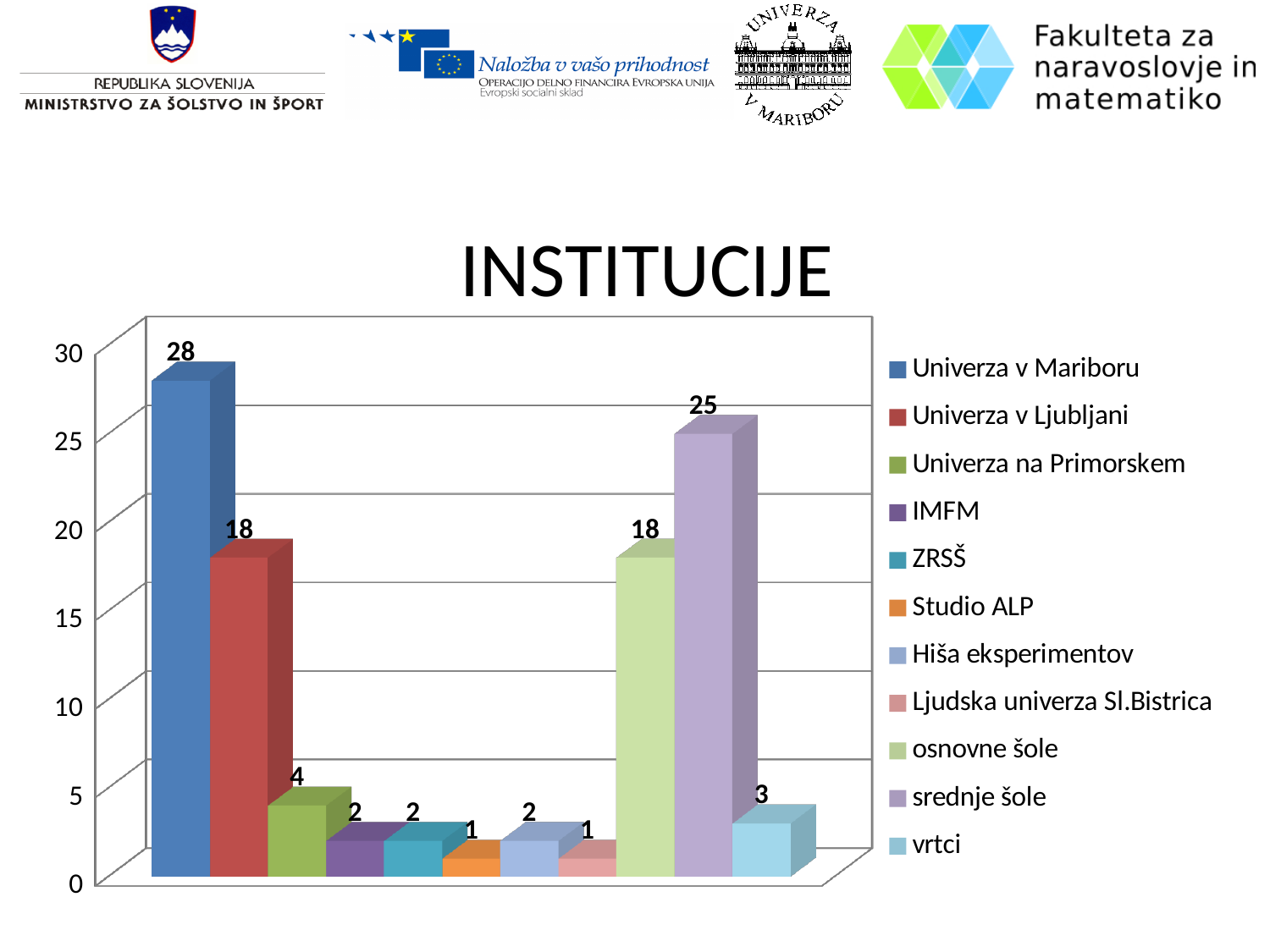
Which institution has the highest value? Univerza v Mariboru Which is larger, the value for osnovne šole or the value for srednje šole? srednje šole What is the value for srednje šole? 25 How many series does the legend list? 11 What kind of chart is shown on the slide? bar chart What is the difference between the values for Univerza v Ljubljani and Univerza na Primorskem? 14 What is the title of the chart? INSTITUCIJE Is the value for Univerza v Ljubljani greater or less than 15? greater What is the value for vrtci? 3 What is the value for Univerza v Mariboru? 28 What is the value for Univerza na Primorskem? 4 What is the difference between the values for Univerza v Mariboru and srednje šole? 3